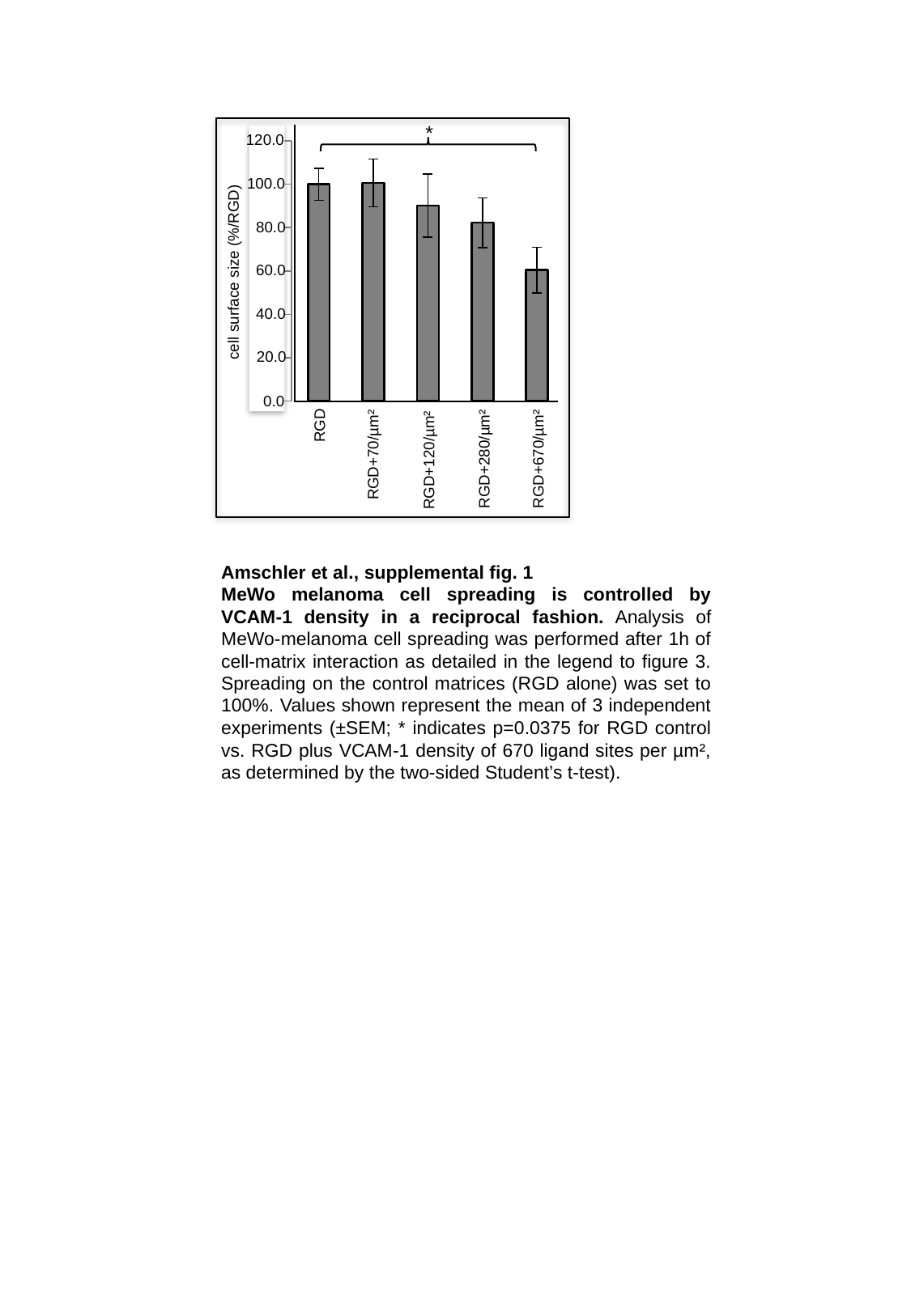
Which is larger, the value for RGD+280/µm² or the value for RGD+670/µm²? RGD+280/µm² What is the cell surface size value for the RGD bar? 100.0 What is the label of the y axis? cell surface size (%/RGD) What kind of chart is shown on the slide? bar chart Is the value for RGD+120/µm² greater or less than 80.0? greater How many bars (categories) are plotted in the chart? 5 Is the value for RGD+280/µm² greater or less than 100.0? less Is the value for RGD+670/µm² greater or less than 80.0? less Do the bar values generally rise or fall from left to right along the x axis? fall Which category has the lowest cell surface size? RGD+670/µm² Which is larger, the value for RGD+120/µm² or the value for RGD+670/µm²? RGD+120/µm²